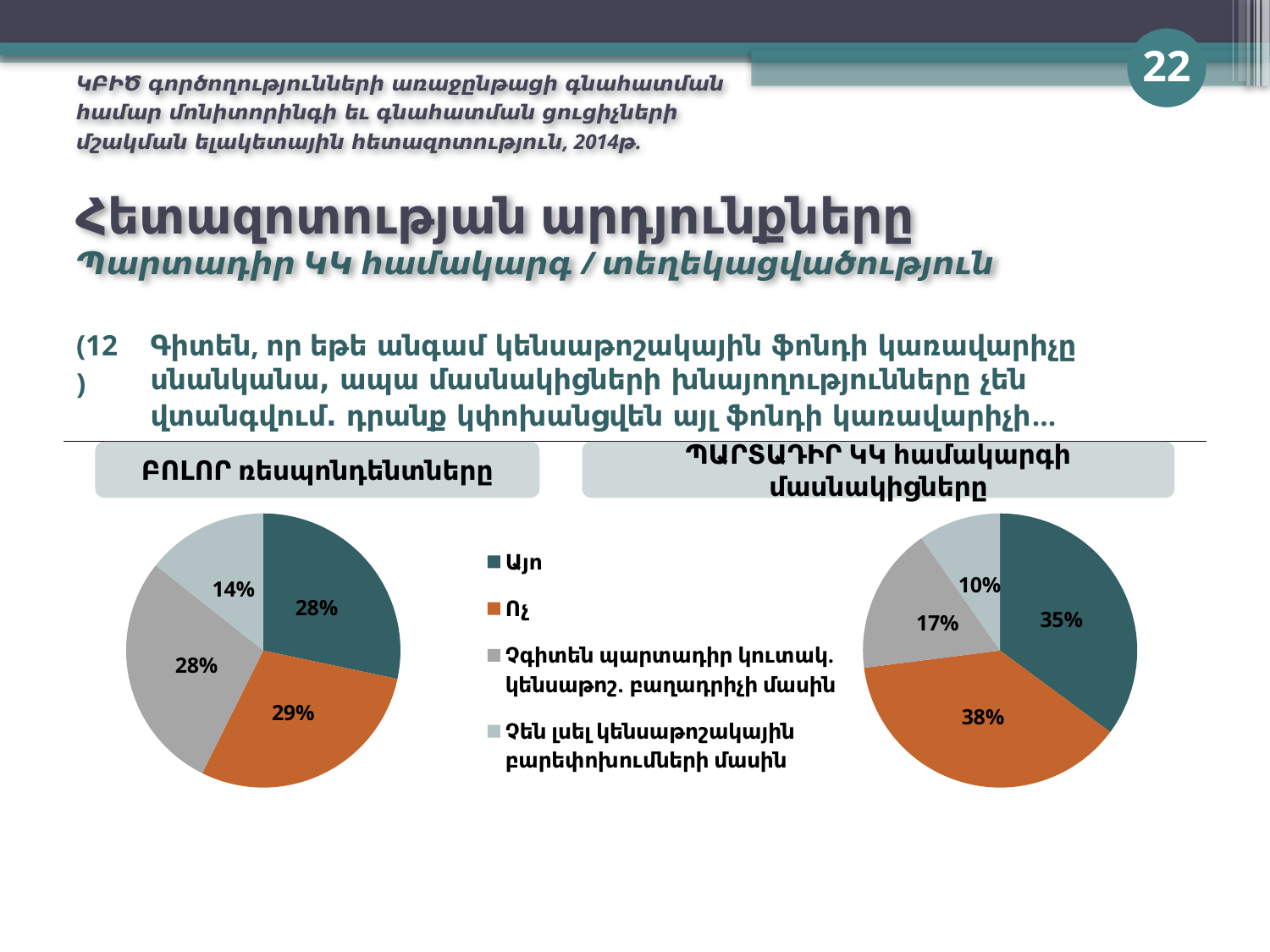
In the left pie chart (ԲՈԼՈՐ ռեսպոնդենտները), what share is labelled for "Չեն լսել կենսաթոշակային բարեփոխումների մասին"? 14% In the right pie chart (ՊԱՐՏԱԴԻՐ ԿԿ համակարգի մասնակիցները), which category has the smallest share? Չեն լսել կենսաթոշակային բարեփոխումների մասին In the right pie chart (ՊԱՐՏԱԴԻՐ ԿԿ համակարգի մասնակիցները), what share is labelled for "Ոչ"? 38% In the left pie chart (ԲՈԼՈՐ ռեսպոնդենտները), what share is labelled for "Այո"? 28% What kind of chart is used on the left, titled "ԲՈԼՈՐ ռեսպոնդենտները"? Pie chart In the right pie chart (ՊԱՐՏԱԴԻՐ ԿԿ համակարգի մասնակիցները), what share is labelled for "Չգիտեն պարտադիր կուտակ. կենսաթոշ. բաղադրիչի մասին"? 17% How many categories does the shared legend list for the pie charts? 4 In the left pie chart (ԲՈԼՈՐ ռեսպոնդենտները), what share is labelled for "Ոչ"? 29% In the left pie chart (ԲՈԼՈՐ ռեսպոնդենտները), which category has the smallest share? Չեն լսել կենսաթոշակային բարեփոխումների մասին In the right pie chart (ՊԱՐՏԱԴԻՐ ԿԿ համակարգի մասնակիցները), what share is labelled for "Այո"? 35% In the right pie chart (ՊԱՐՏԱԴԻՐ ԿԿ համակարգի մասնակիցները), which category has the largest share? Ոչ What is the difference between the "Ոչ" share in the right pie chart (38%) and the "Ոչ" share in the left pie chart (29%)? 9%